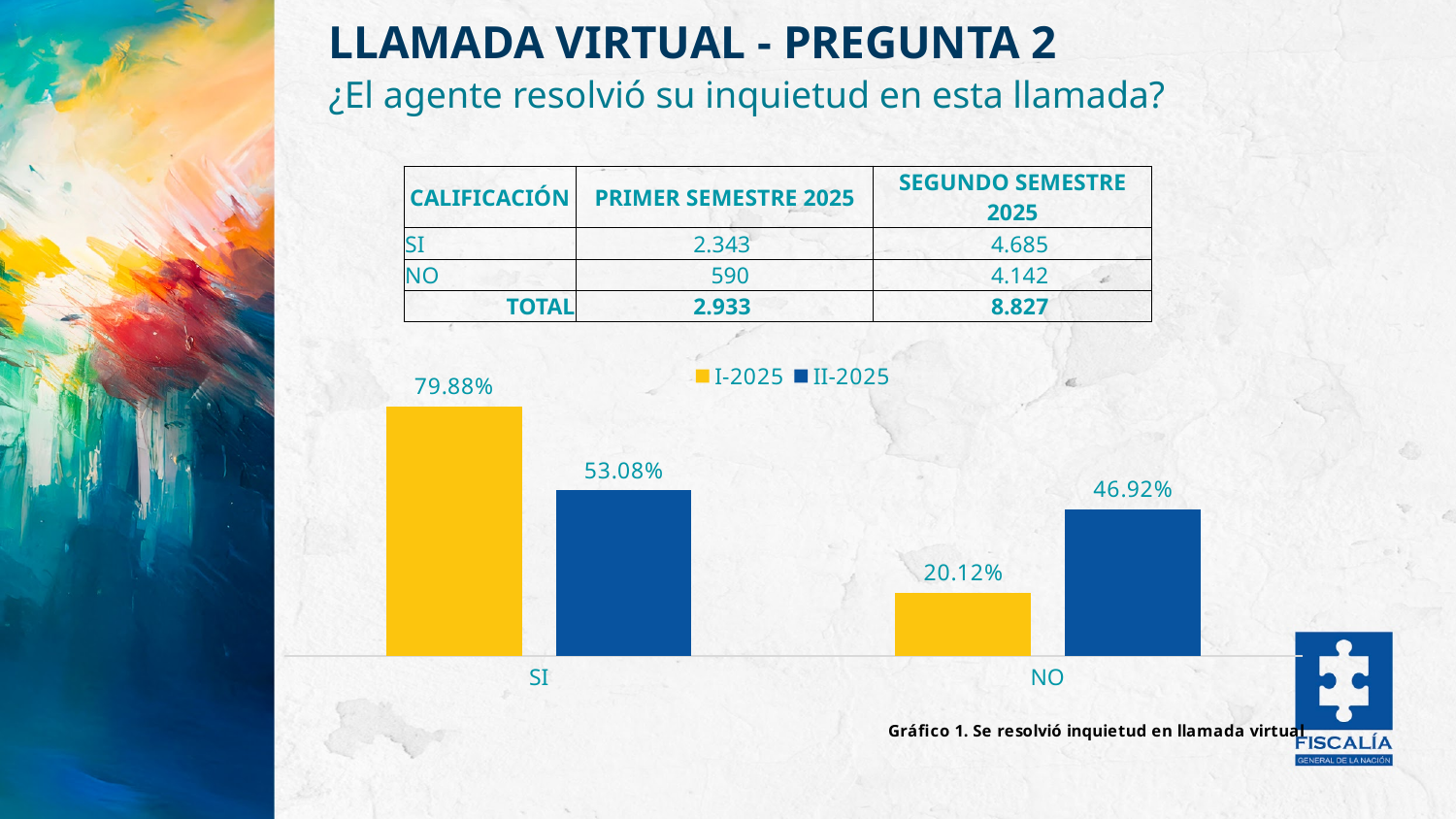
For NO, which series has the larger value, I-2025 or II-2025? II-2025 Which category has the lowest value in the I-2025 series? NO What kind of chart is shown on the slide? Bar chart What is the difference between the I-2025 and II-2025 values for SI? 26.80% What is the value for NO in the I-2025 series? 20.12% Which category has the highest value in the I-2025 series? SI How many categories are shown on the x axis of the chart? 2 What is the value for SI in the I-2025 series? 79.88% Which colour represents the II-2025 series in the chart? Blue How many series does the chart legend list? 2 What is the value for NO in the II-2025 series? 46.92% What is the value for SI in the II-2025 series? 53.08%